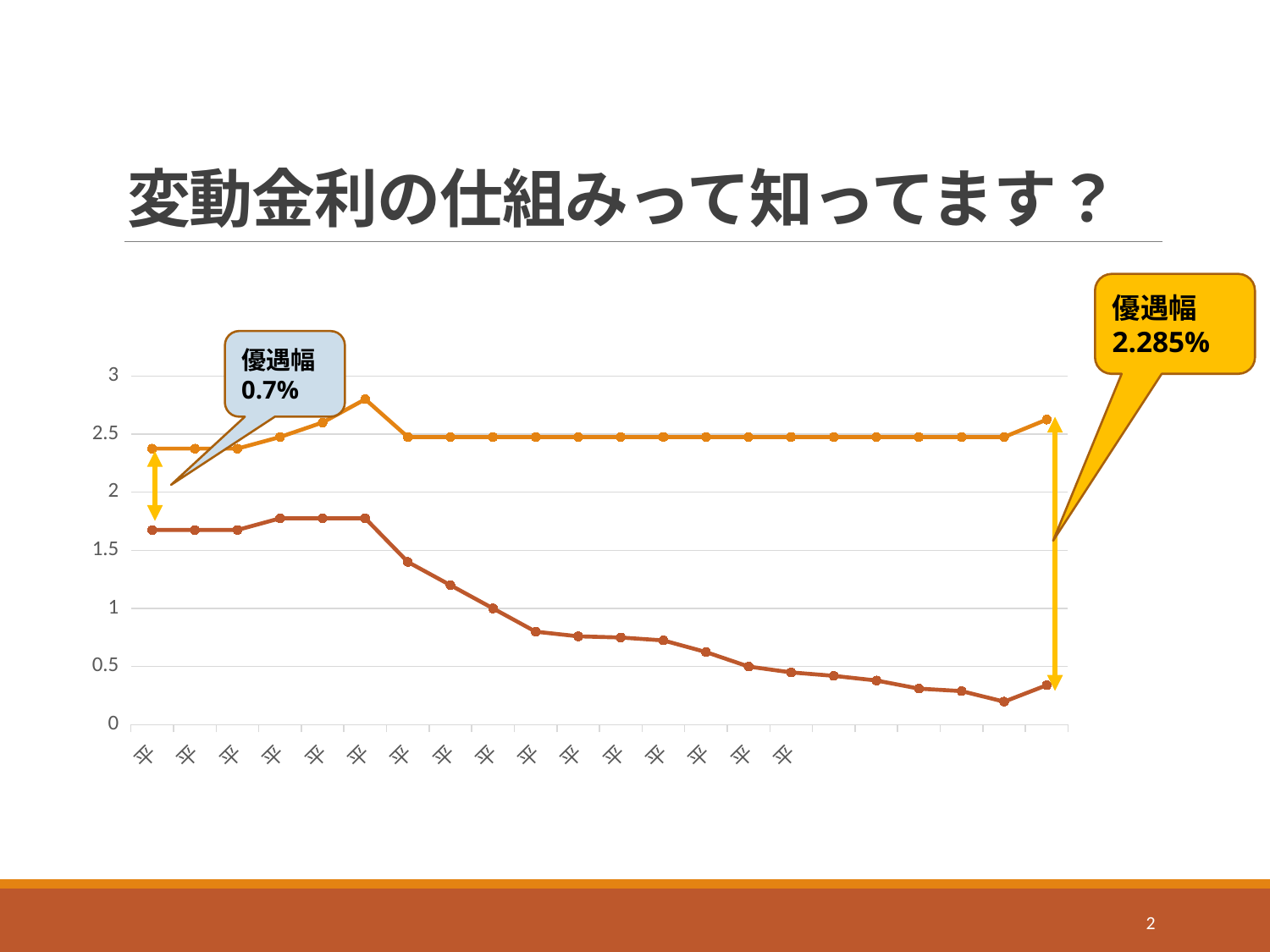
Is the lowest point of the lower (dark brown) line greater or less than 0.5? less Is the last point of the lower (dark brown) line greater or less than 0.5? less Is the first point of the upper (orange) line greater or less than 2? greater Does the lower (dark brown) line generally rise or fall from left to right? fall What is the highest value shown on the y axis? 3 What 優遇幅 value is shown in the callout at the right end of the chart? 2.285% What kind of chart is shown on the slide? line chart At the first point on the x axis, which line has the higher value, the upper orange line or the lower dark brown line? the upper orange line How many lines are plotted on the chart? 2